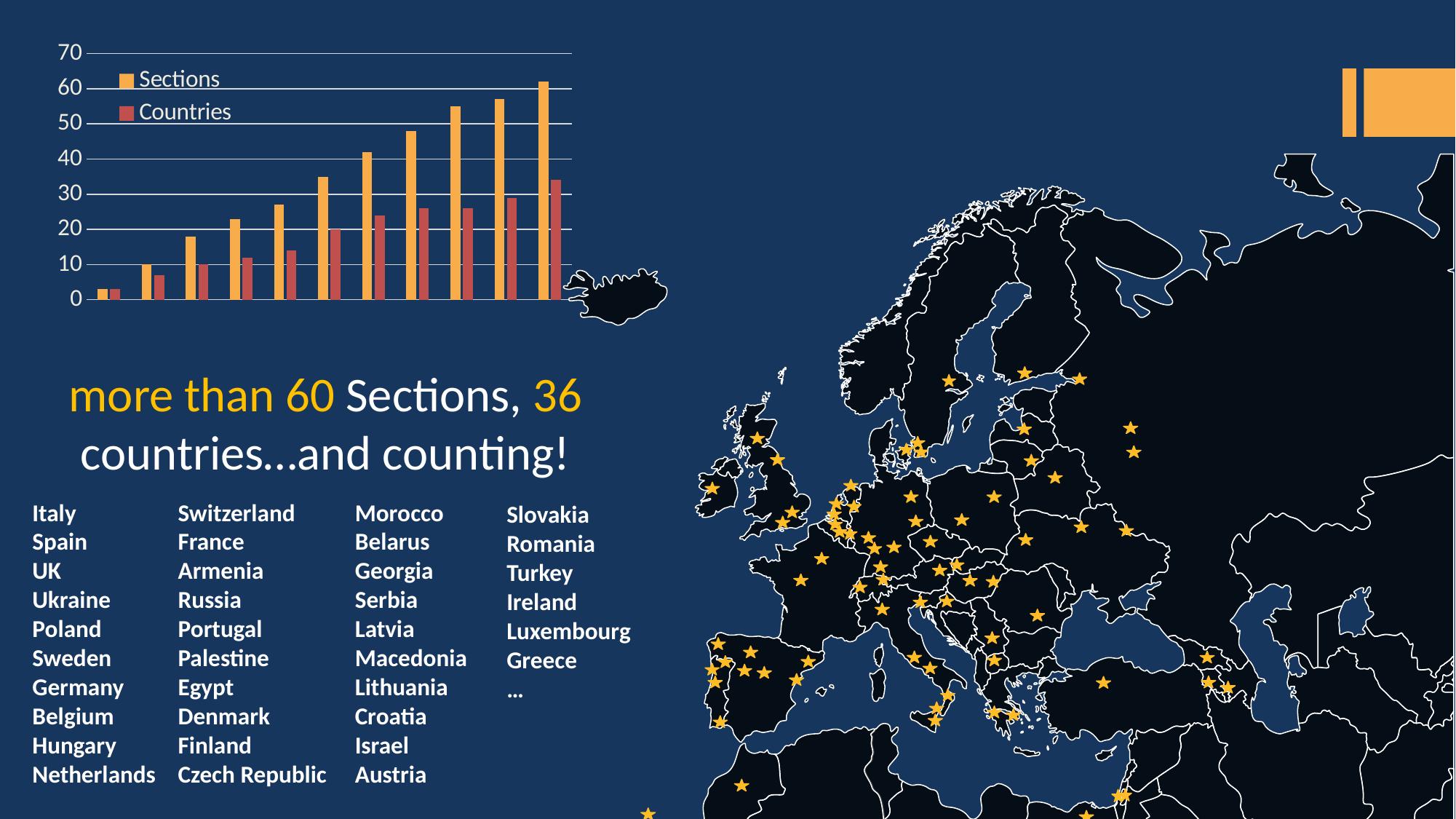
Which colour represents the Sections series in the chart? orange What are the two series named in the chart's legend? Sections and Countries Is the Sections value for the rightmost group greater or less than 50? greater Do the Sections values rise or fall from left to right along the x axis? rise In the rightmost group, which is larger, the Sections bar or the Countries bar? Sections Is the Countries value for the rightmost group greater or less than 30? greater Which group of bars has the lowest Sections value? the leftmost (first) group What kind of chart is shown on the slide? bar chart How many series does the chart's legend list? 2 Which group of bars has the highest Sections value? the rightmost (last) group How many groups of bars are plotted in the chart? 11 Do the Countries values rise or fall from left to right along the x axis? rise